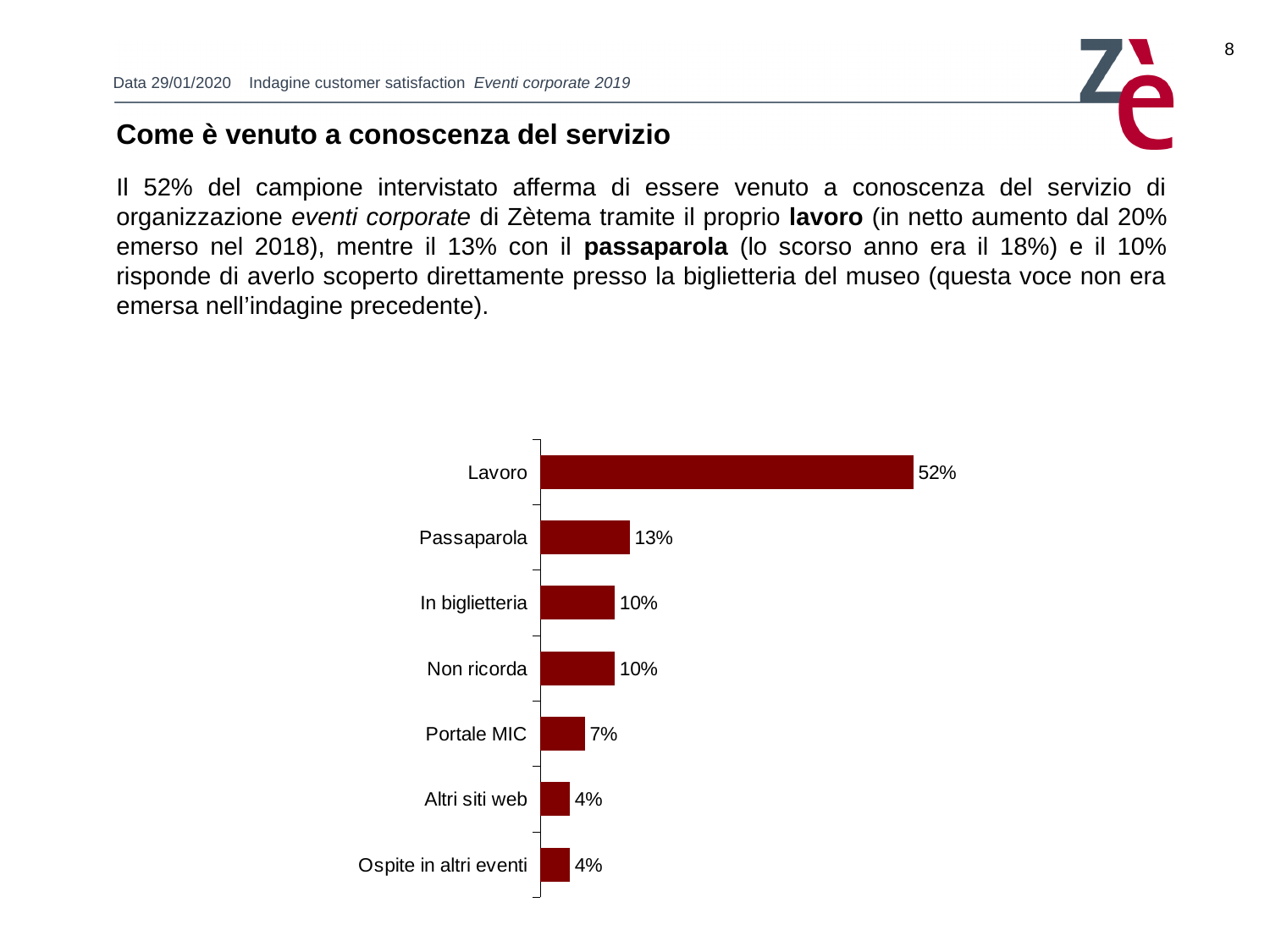
What is the value for Portale MIC? 7% What is the value for In biglietteria? 10% What is the difference between the values for Non ricorda and Portale MIC? 3% What kind of chart is shown on the slide? Bar chart Which is larger, the value for Passaparola or the value for In biglietteria? Passaparola How many categories are shown in the chart? 7 What is the title of the slide containing the chart? Come è venuto a conoscenza del servizio Which is larger, the value for Portale MIC or the value for Altri siti web? Portale MIC Which category has the highest value? Lavoro What is the value for Lavoro? 52% What is the difference between the values for Lavoro and Passaparola? 39% What is the value for Passaparola? 13%